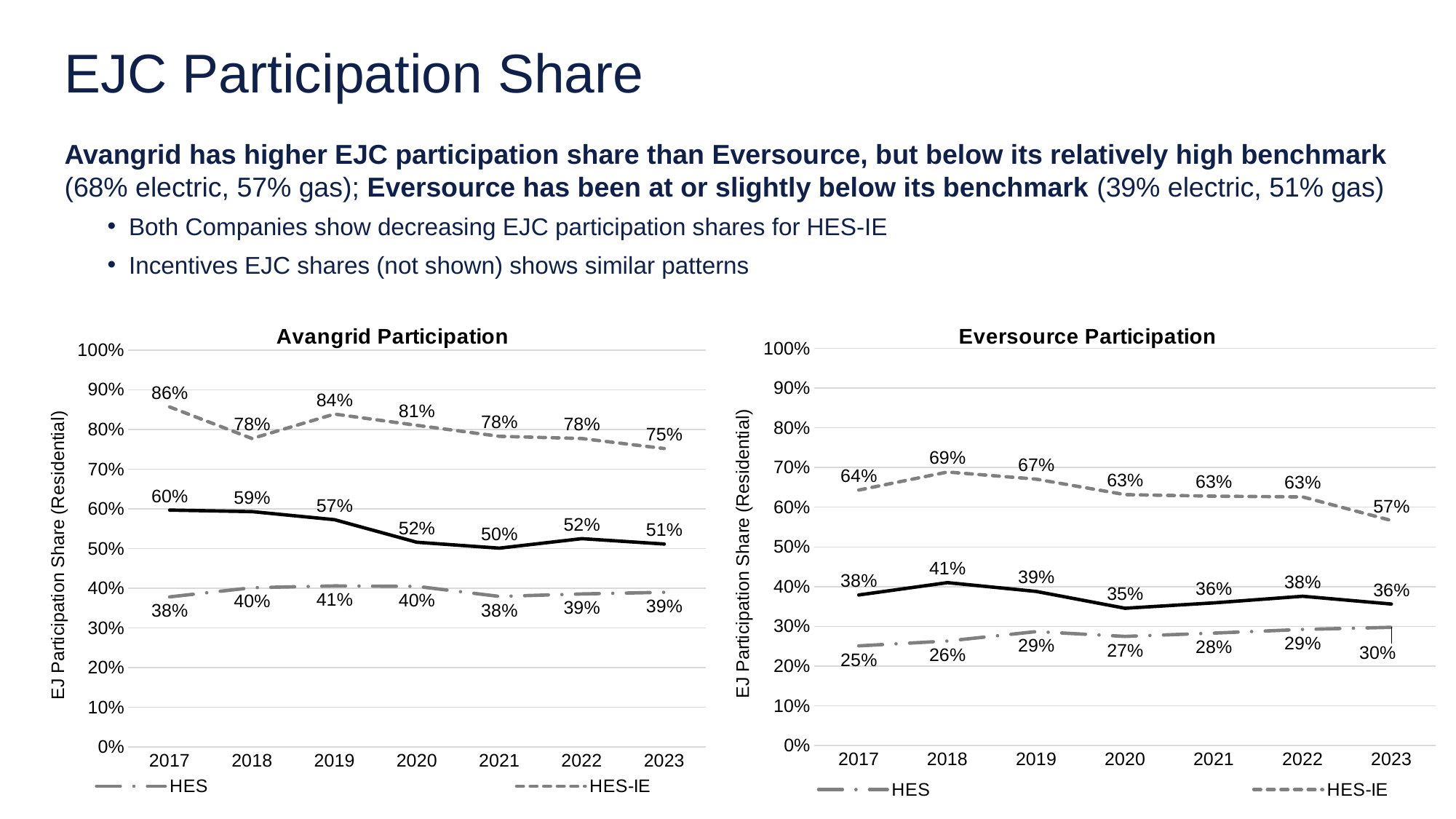
How many years are shown on the x axis of the Eversource Participation chart? 7 In the Avangrid Participation chart, which year has the lowest HES-IE value? 2023 How many series does the legend of the Avangrid Participation chart list? 2 In the Eversource Participation chart, what is the HES value for 2017? 25% In the Eversource Participation chart, which is larger: the HES-IE value for 2018 or for 2020? 2018 What kind of chart is the Avangrid Participation chart? Line chart In the Eversource Participation chart, does the HES-IE series generally rise or fall from 2018 to 2023? Fall In the Avangrid Participation chart, what is the HES-IE value for 2017? 86% In the Eversource Participation chart, what is the HES-IE value for 2023? 57% In the Eversource Participation chart, which year has the highest HES-IE value? 2018 In the Avangrid Participation chart, what is the difference between the HES-IE values for 2017 and 2023? 11% In the Avangrid Participation chart, what is the HES value for 2019? 41%